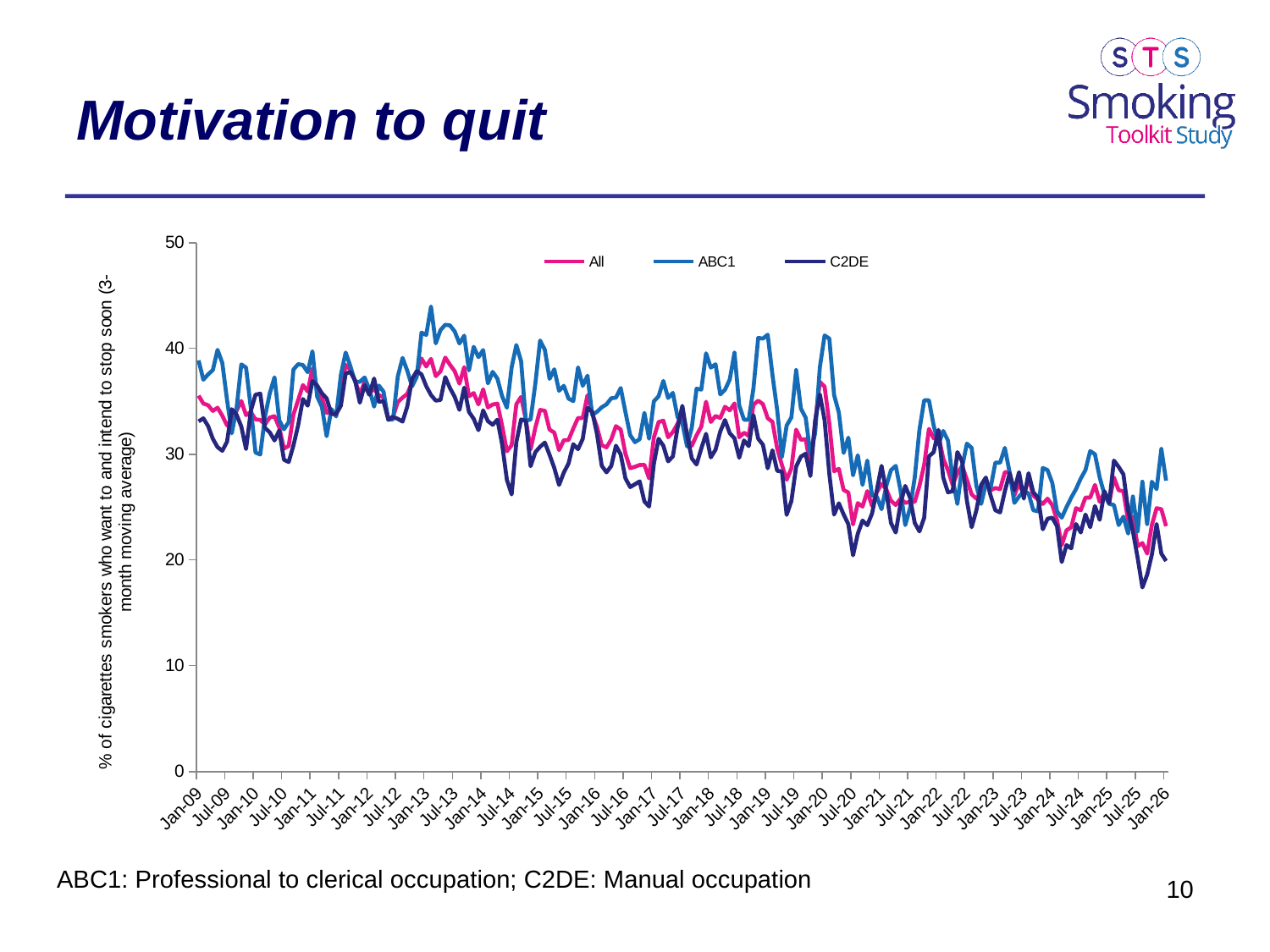
Is the lowest value for C2DE around Jul-25 greater or less than 20? less Is the value for C2DE at Jan-26 greater or less than 30? less Which series are listed in the chart's legend? All, ABC1, C2DE What kind of chart is shown on the slide? line chart Is the value for ABC1 around Jan-13 greater or less than 40? greater Overall, do the values rise or fall from Jan-09 to Jan-26? fall Around Jan-13, which series has the highest value? ABC1 What is the title of the slide containing the chart? Motivation to quit Around Jan-13, which is larger, the value for ABC1 or the value for C2DE? ABC1 What is the highest value shown on the y axis? 50 How many series does the legend list? 3